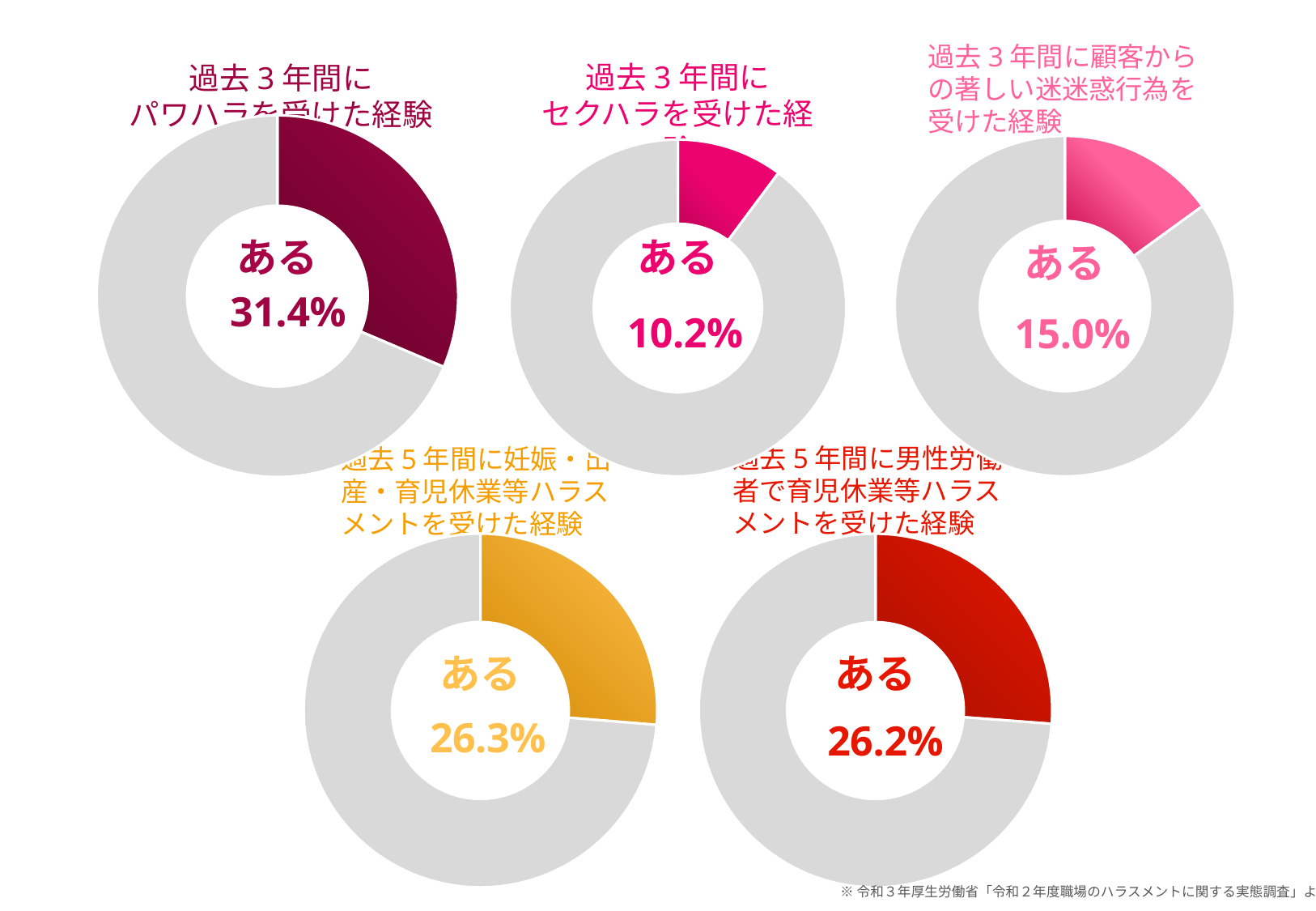
Across the five donut charts, which type of harassment has the lowest ある percentage? セクハラ (10.2%) What is the difference in percentage points between the ある value in the パワハラ chart and the ある value in the セクハラ chart? 21.2 percentage points In the donut chart titled 過去３年間にパワハラを受けた経験, what percentage is shown for ある? 31.4% How many donut charts are shown on the slide? 5 In the donut chart about 顧客からの著しい迷惑行為 (top right), what percentage is shown for ある? 15.0% Which is larger: the ある value in the 顧客からの著しい迷惑行為 chart or the ある value in the 妊娠・出産・育児休業等ハラスメント chart? 妊娠・出産・育児休業等ハラスメント (26.3%) In the bottom-right donut chart about 男性労働者で育児休業等ハラスメント, what percentage is shown for ある? 26.2% What kind of chart is used to show each harassment experience percentage on this slide? Donut (pie) chart In the donut chart titled 過去３年間にセクハラを受けた経験, what percentage is shown for ある? 10.2% Across the five donut charts, which type of harassment has the highest ある percentage? パワハラ (31.4%) In the bottom-left donut chart about 妊娠・出産・育児休業等ハラスメント, what percentage is shown for ある? 26.3% In the パワハラ donut chart, what colour is the ある segment? Dark red (maroon)